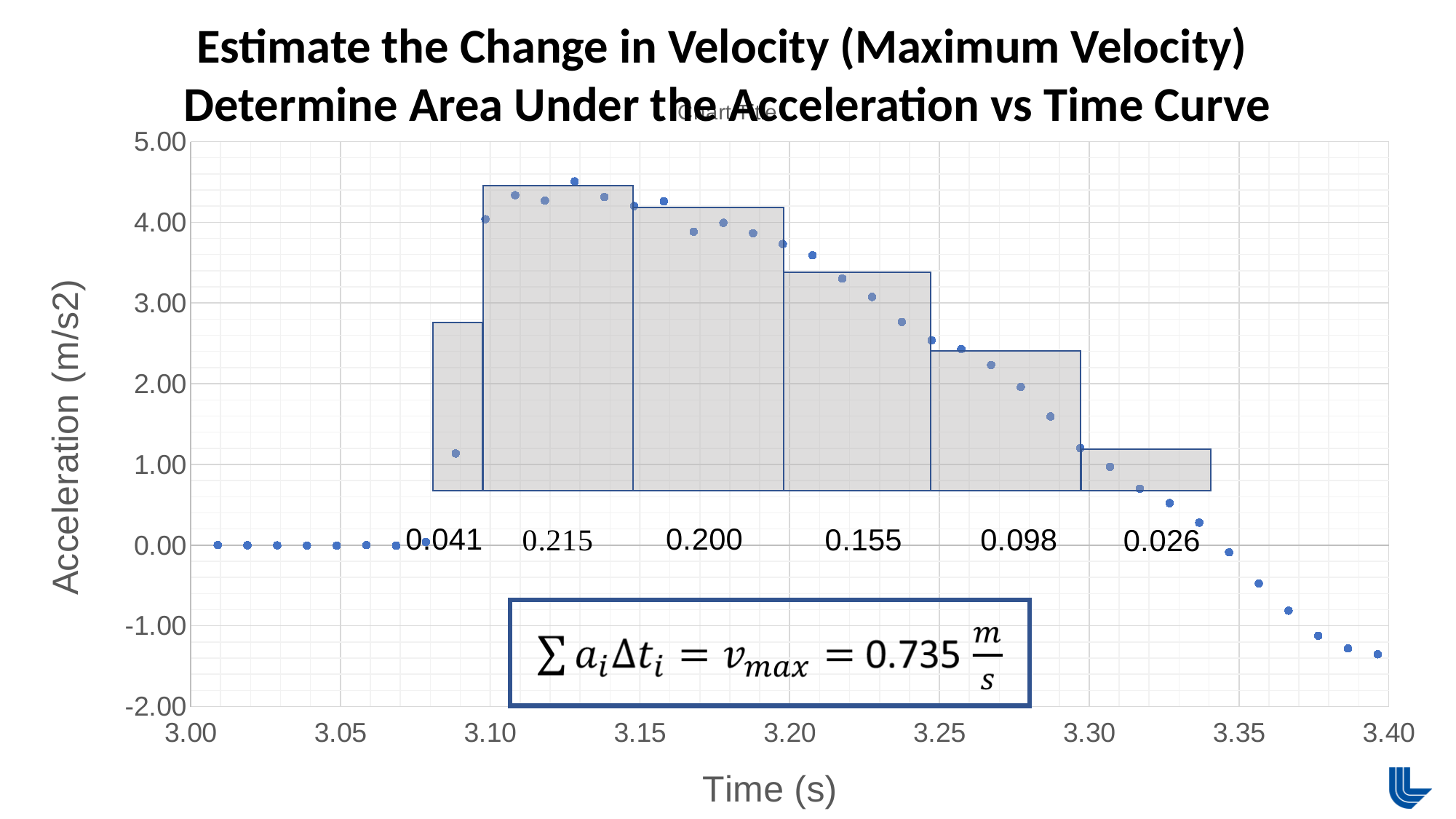
Do the acceleration values rise or fall between about 3.13 s and 3.40 s? fall Is the acceleration value at about 3.40 s greater or less than -1.00? less What is the difference between the rectangle area labels 0.215 and 0.155? 0.060 What is the sum of all six rectangle area labels, as given in the boxed equation? 0.735 m/s Is the acceleration value at about 3.13 s greater or less than 4.00? greater How many shaded rectangles with area labels are drawn under the curve? 6 What is the title of the horizontal axis of the chart? Time (s) What is the title of the vertical axis of the chart? Acceleration (m/s2) Which rectangle area label is the largest? 0.215 What kind of chart is shown on the slide? scatter chart Which rectangle area label is the smallest? 0.026 What is the area label of the rectangle spanning roughly 3.15 s to 3.20 s? 0.200